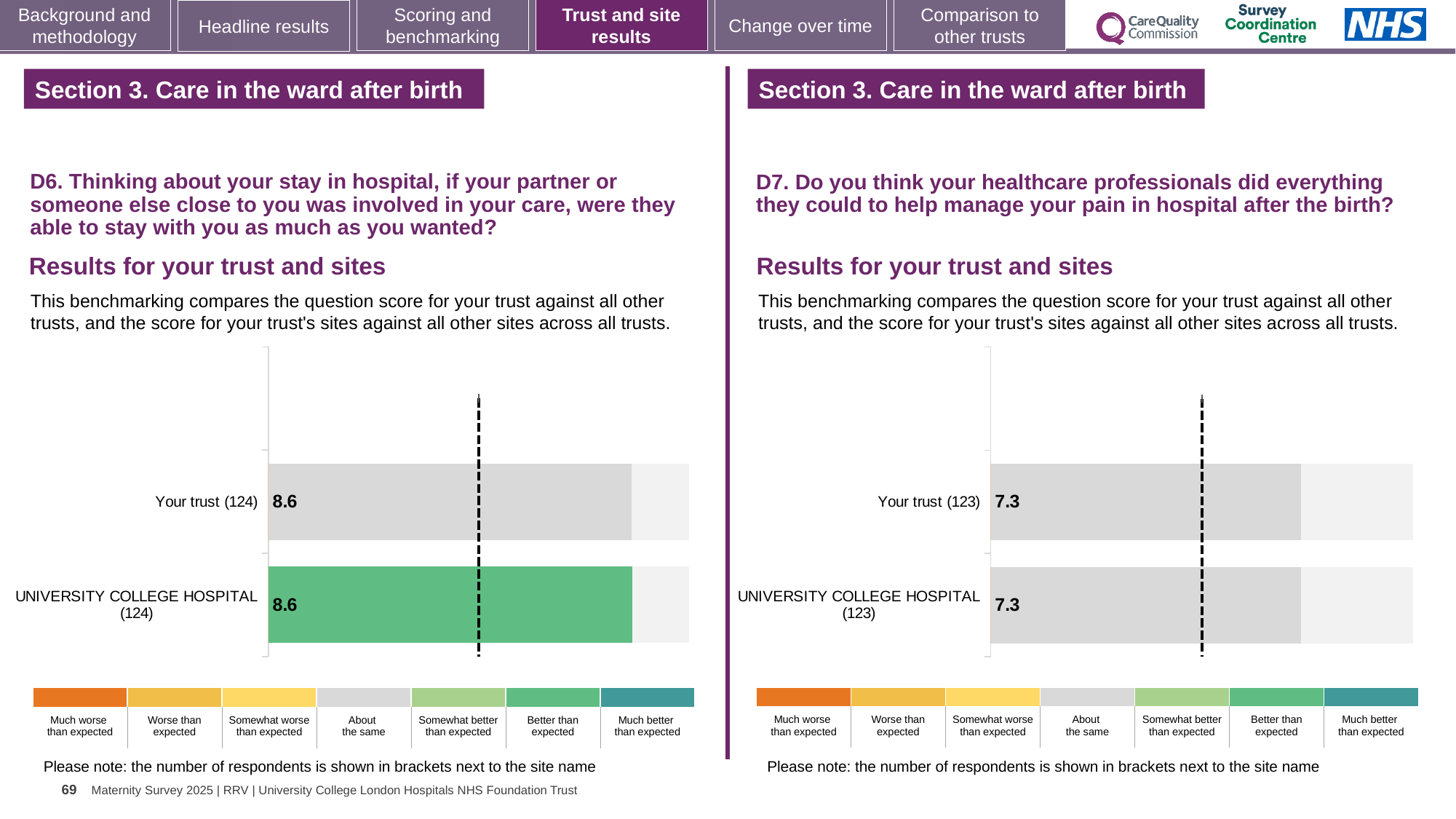
In the D7 chart on the right, what is the score for UNIVERSITY COLLEGE HOSPITAL? 7.3 In the D6 chart on the left, what is the score for Your trust? 8.6 In the D7 chart on the right, what is the score for Your trust? 7.3 How many bars are plotted in the D7 chart on the right? 2 In the D7 chart on the right, what is the difference between the score for Your trust and the score for UNIVERSITY COLLEGE HOSPITAL? 0.0 How many bars are plotted in the D6 chart on the left? 2 In the D6 chart on the left, how many respondents are shown in brackets for UNIVERSITY COLLEGE HOSPITAL? 124 In the D7 chart on the right, how many respondents are shown in brackets for Your trust? 123 In the D6 chart on the left, what is the score for UNIVERSITY COLLEGE HOSPITAL? 8.6 What kind of chart is used for the D6 results on the left? Bar chart In the D6 chart on the left, what is the difference between the score for Your trust and the score for UNIVERSITY COLLEGE HOSPITAL? 0.0 In the D6 chart on the left, which benchmark category does the green colour of the UNIVERSITY COLLEGE HOSPITAL bar correspond to in the legend? Better than expected